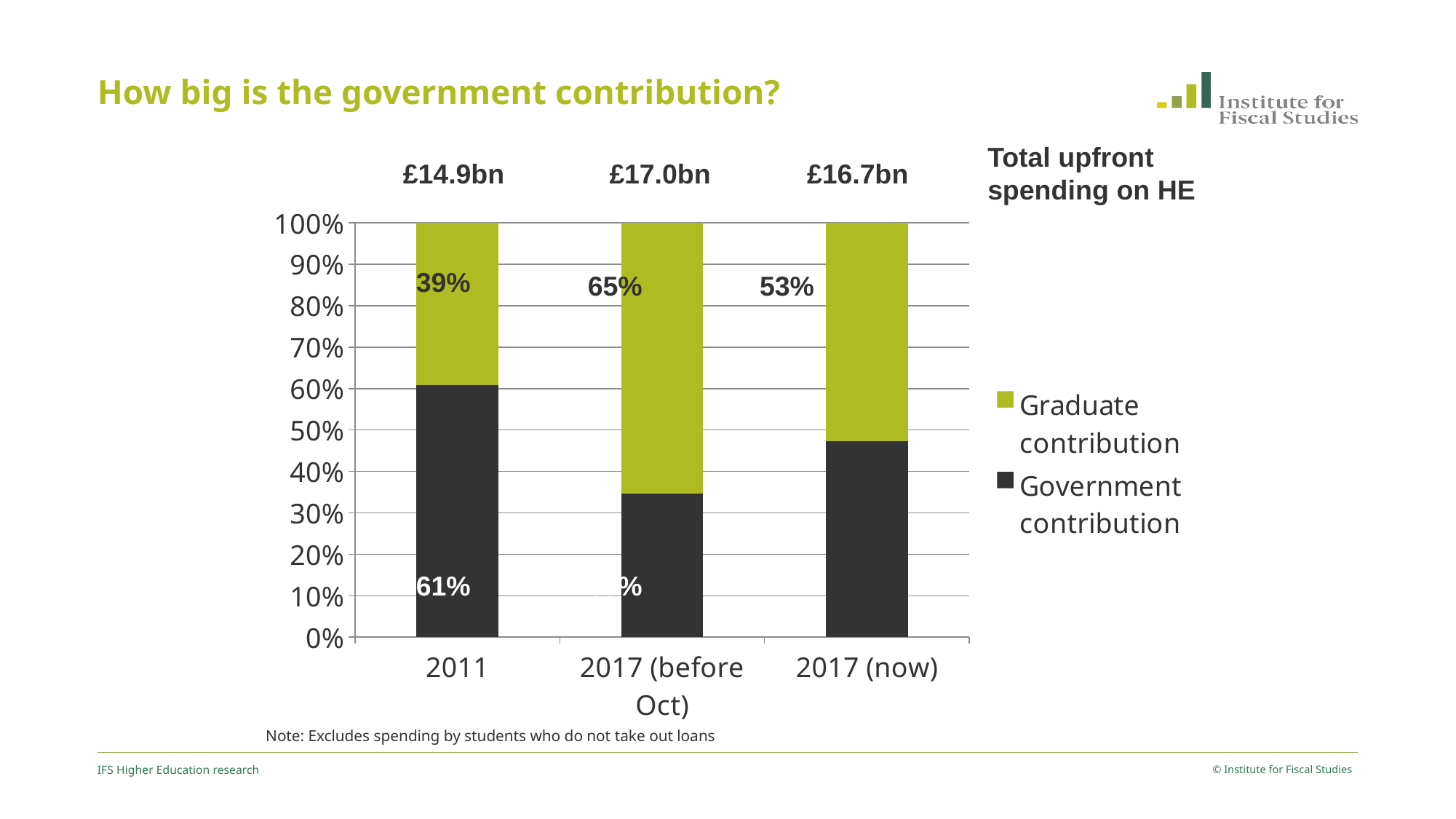
Which category has the lowest Graduate contribution share? 2011 What is the Graduate contribution share for 2011? 39% What is the total upfront spending on HE shown above the 2017 (now) bar? £16.7bn What kind of chart is shown on the slide? Stacked bar chart What is the Graduate contribution share for 2017 (now)? 53% How many categories are shown on the x axis? 3 What is the Graduate contribution share for 2017 (before Oct)? 65% Is the Government contribution share for 2017 (now) greater or less than 50%? less What is the Government contribution share for 2011? 61% Which category has the highest total upfront spending on HE? 2017 (before Oct) How many series does the legend list? 2 What is the difference in Graduate contribution share between 2017 (before Oct) and 2011? 26 percentage points